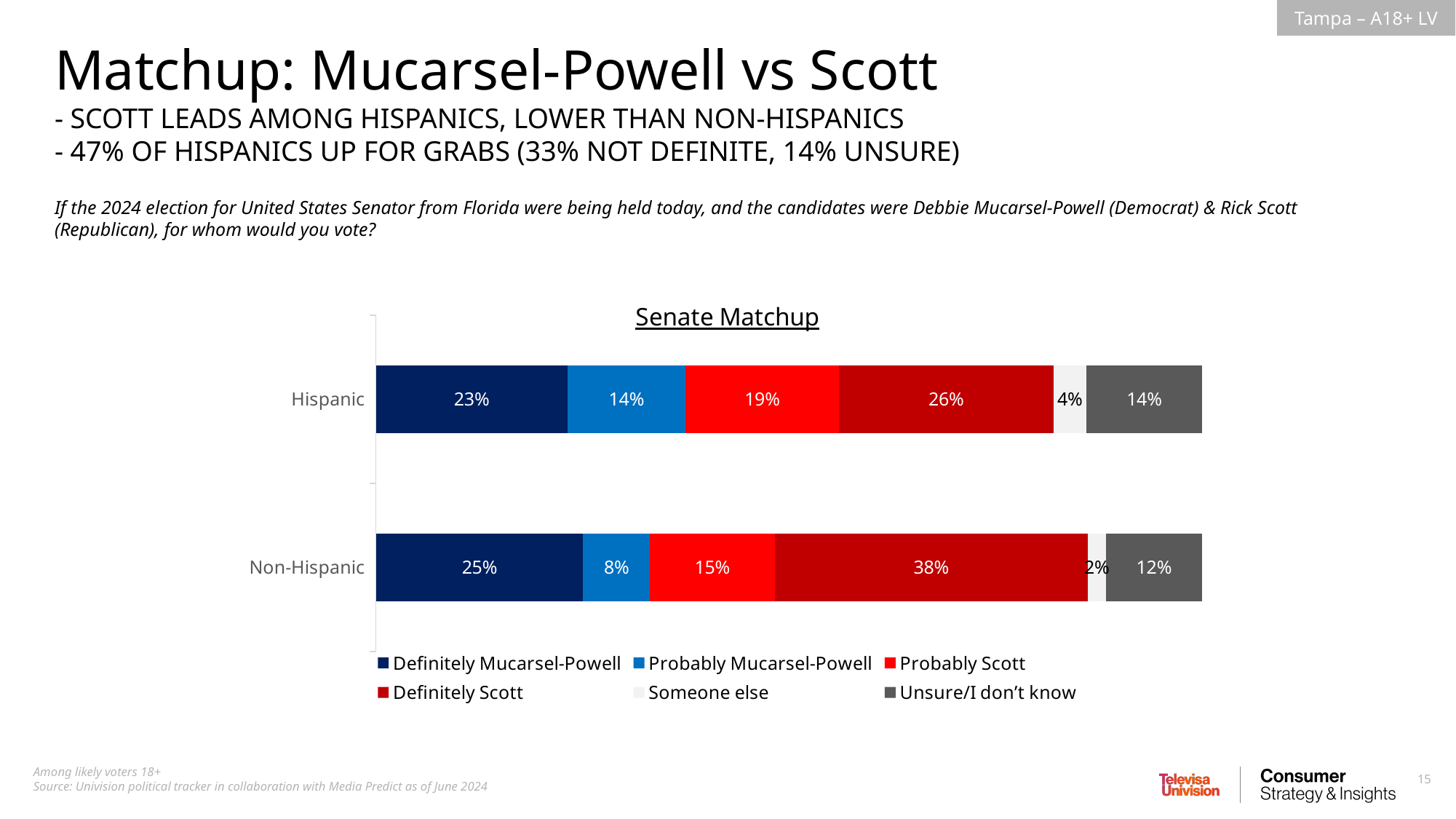
How many series does the legend list? 6 What is the difference between the Definitely Scott values for Non-Hispanic and Hispanic voters? 12 percentage points What percentage of Non-Hispanic likely voters say they would definitely vote for Scott? 38% What is the Probably Scott value for Hispanic voters? 19% Which response category has the smallest share among Non-Hispanic voters? Someone else Which response category has the largest share among Hispanic voters? Definitely Scott What percentage of Hispanic likely voters say they would definitely vote for Mucarsel-Powell? 23% Which group has the higher Definitely Scott share, Hispanic or Non-Hispanic? Non-Hispanic How many groups (categories) are shown on the chart? 2 What is the Unsure/I don't know value for Non-Hispanic voters? 12% What is the difference between the Probably Mucarsel-Powell values for Hispanic and Non-Hispanic voters? 6 percentage points What type of chart is the Senate Matchup chart? Stacked bar chart